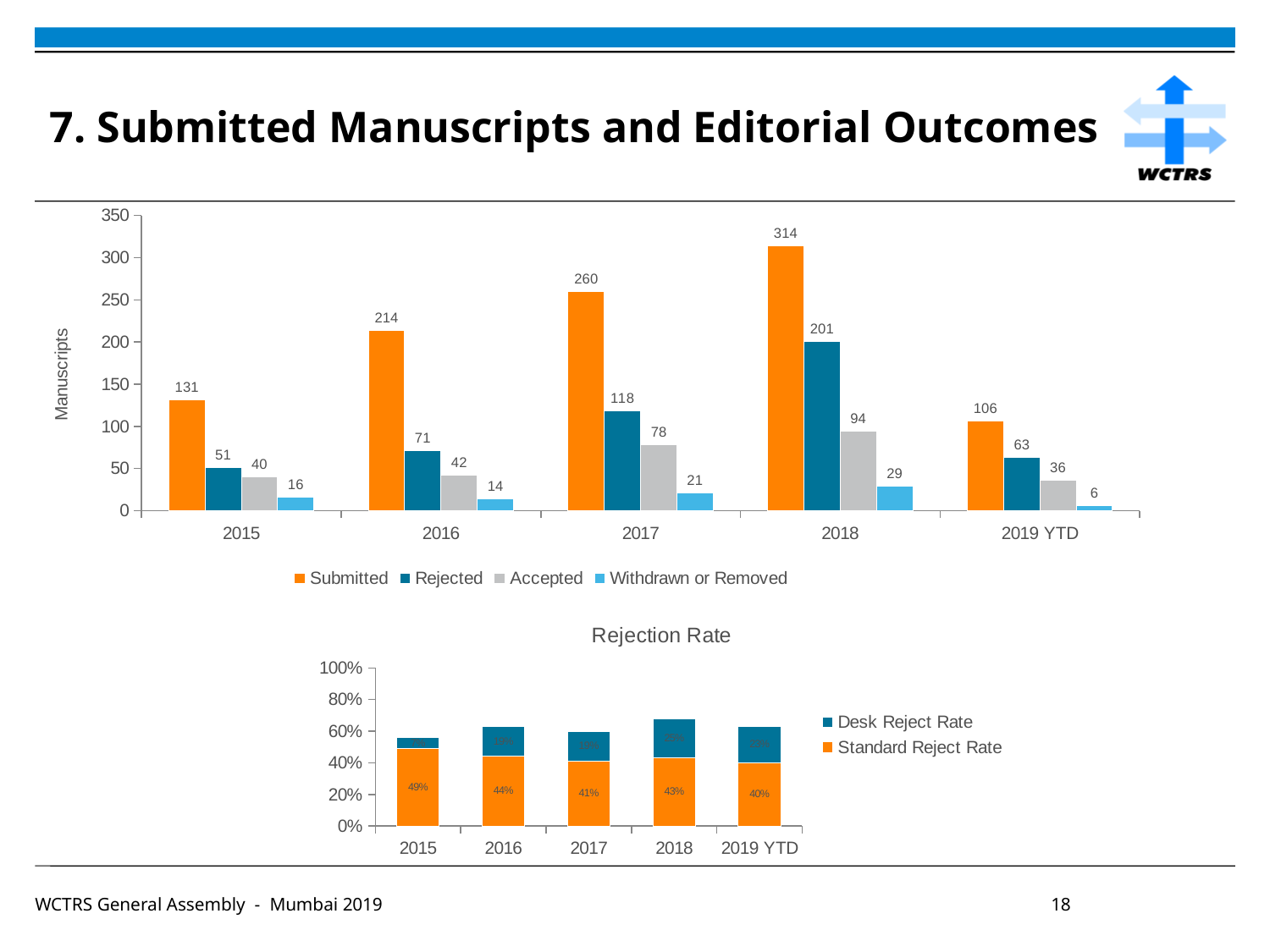
In the Rejection Rate chart, is the total rejection rate for 2018 greater or less than 60%? greater In the top chart, how many series does the legend list? 4 In the top chart, what is the difference between submitted and rejected manuscripts in 2016? 143 In the Rejection Rate chart, what is the Standard Reject Rate for 2015? 49% In the top chart, were more manuscripts rejected in 2017 or in 2019 YTD? 2017 In the top chart, do the submitted manuscript values rise or fall from 2015 to 2018? rise What kind of chart is the Rejection Rate chart? stacked bar chart In the top chart, how many years are shown on the x axis? 5 In the top chart, how many manuscripts were submitted in 2018? 314 In the top chart, how many manuscripts were accepted in 2017? 78 In the top chart, which year has the highest number of submitted manuscripts? 2018 In the top chart, which year has the lowest number of withdrawn or removed manuscripts? 2019 YTD